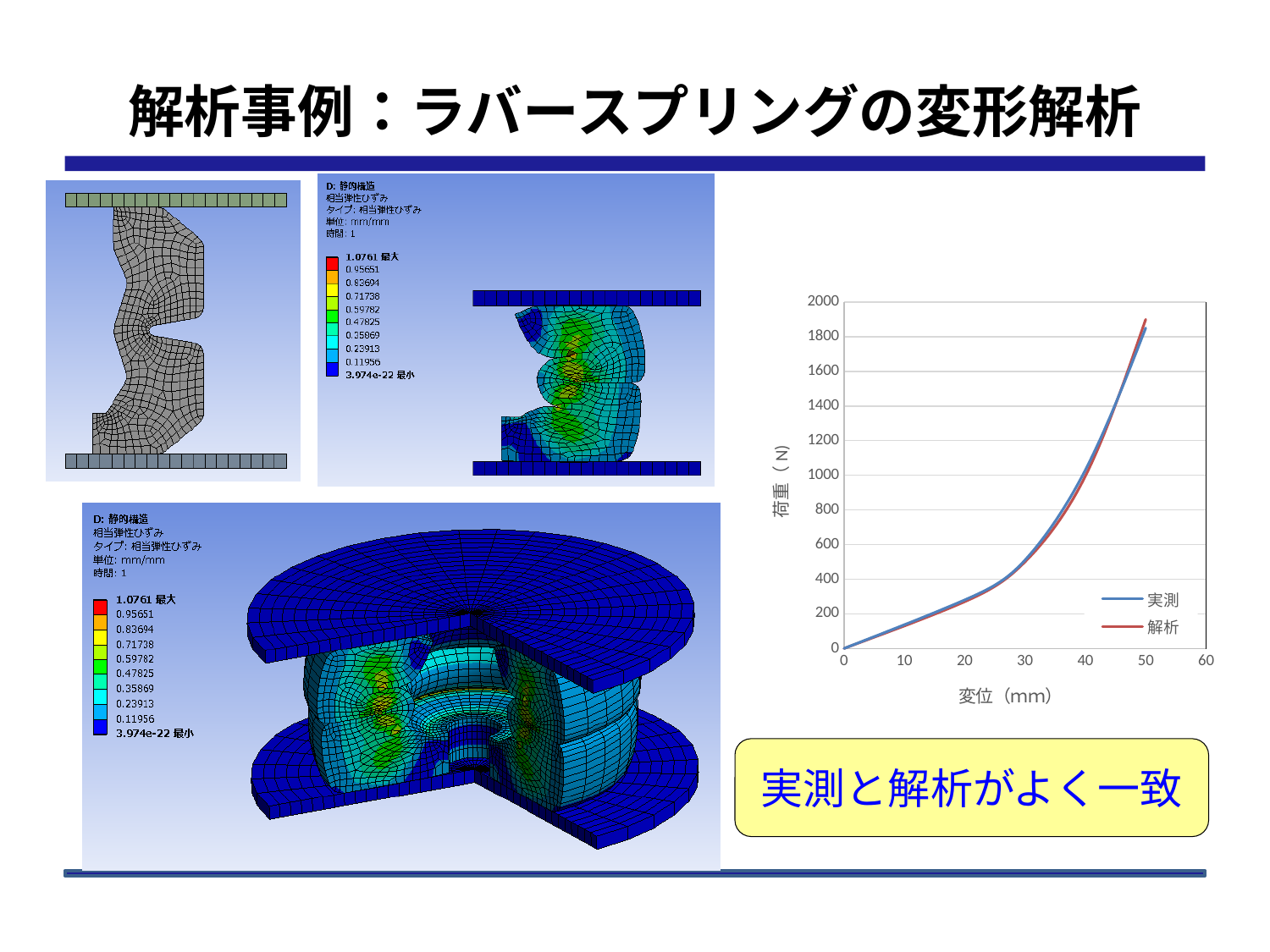
What is the highest value shown on the y axis of the line chart? 2000 In the line chart, is the load (荷重) at a displacement of 20 mm greater or less than 400? less In the line chart, is the load (荷重) at a displacement of 10 mm greater or less than 200? less How many series does the legend of the line chart list? 2 In the line chart, is the load (荷重) at a displacement of 30 mm greater or less than 400? greater Do the values in the line chart rise or fall as displacement (変位) increases along the x axis? rise What is the label of the y axis of the line chart? 荷重（N） What kind of chart is shown on the right side of the slide? line chart What are the two series named in the legend of the line chart? 実測 and 解析